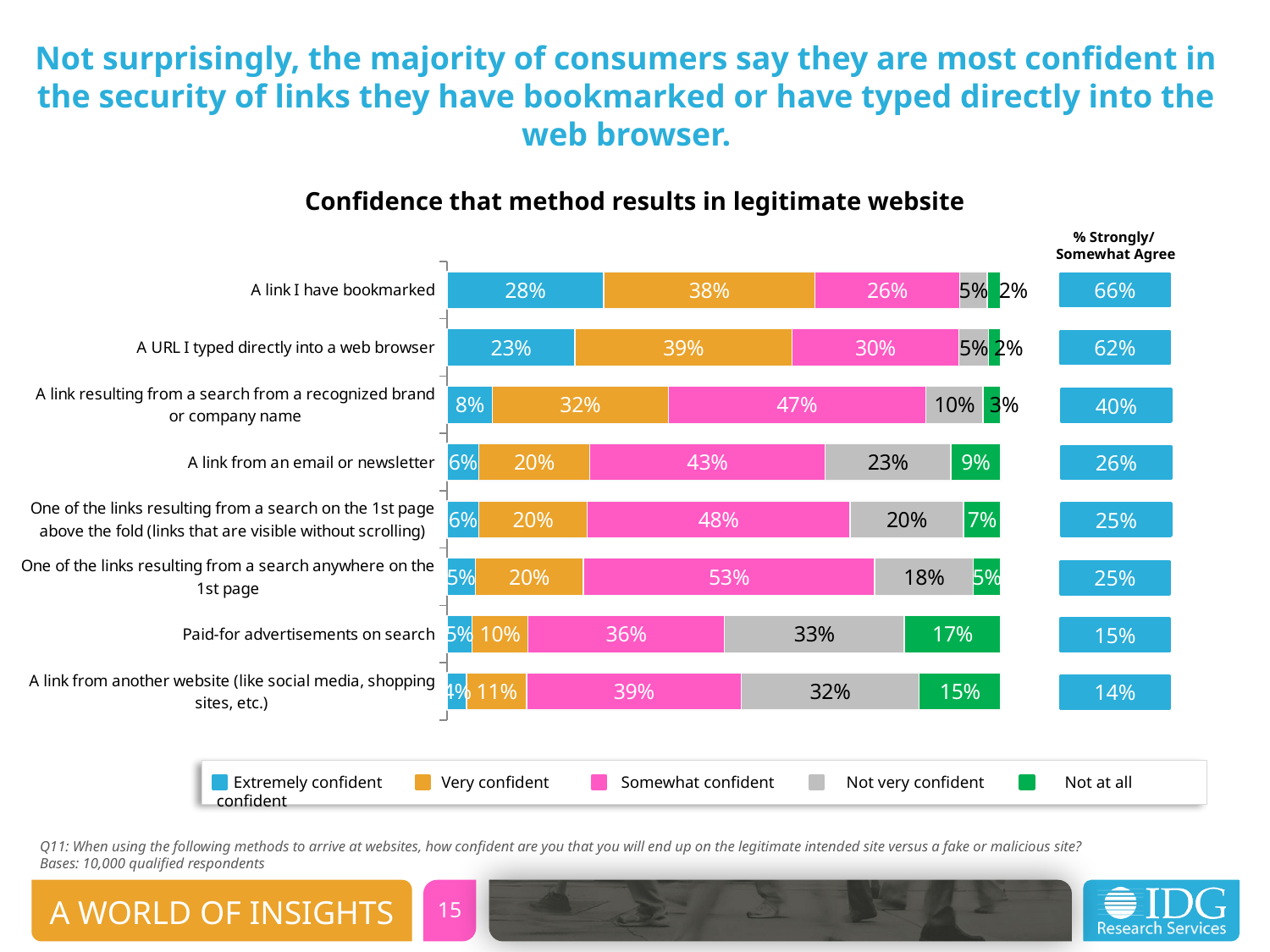
What is the difference between the Very confident values for 'A URL I typed directly into a web browser' and 'A link I have bookmarked'? 1% Which method has the highest % Strongly/Somewhat Agree value? A link I have bookmarked How many methods (categories) are plotted in the chart? 8 What is the Not at all confident value for 'A link from an email or newsletter'? 9% Which method has the lowest % Strongly/Somewhat Agree value? A link from another website (like social media, shopping sites, etc.) What is the title of the chart? Confidence that method results in legitimate website What percentage of respondents are Extremely confident in 'A link I have bookmarked'? 28% What type of chart is shown on the slide? Stacked bar chart What is the Somewhat confident value for 'One of the links resulting from a search anywhere on the 1st page'? 53% What is the Not very confident value for 'Paid-for advertisements on search'? 33% How many series does the legend list? 5 Which is larger: the Not at all confident value for 'Paid-for advertisements on search' or for 'A link from another website (like social media, shopping sites, etc.)'? Paid-for advertisements on search